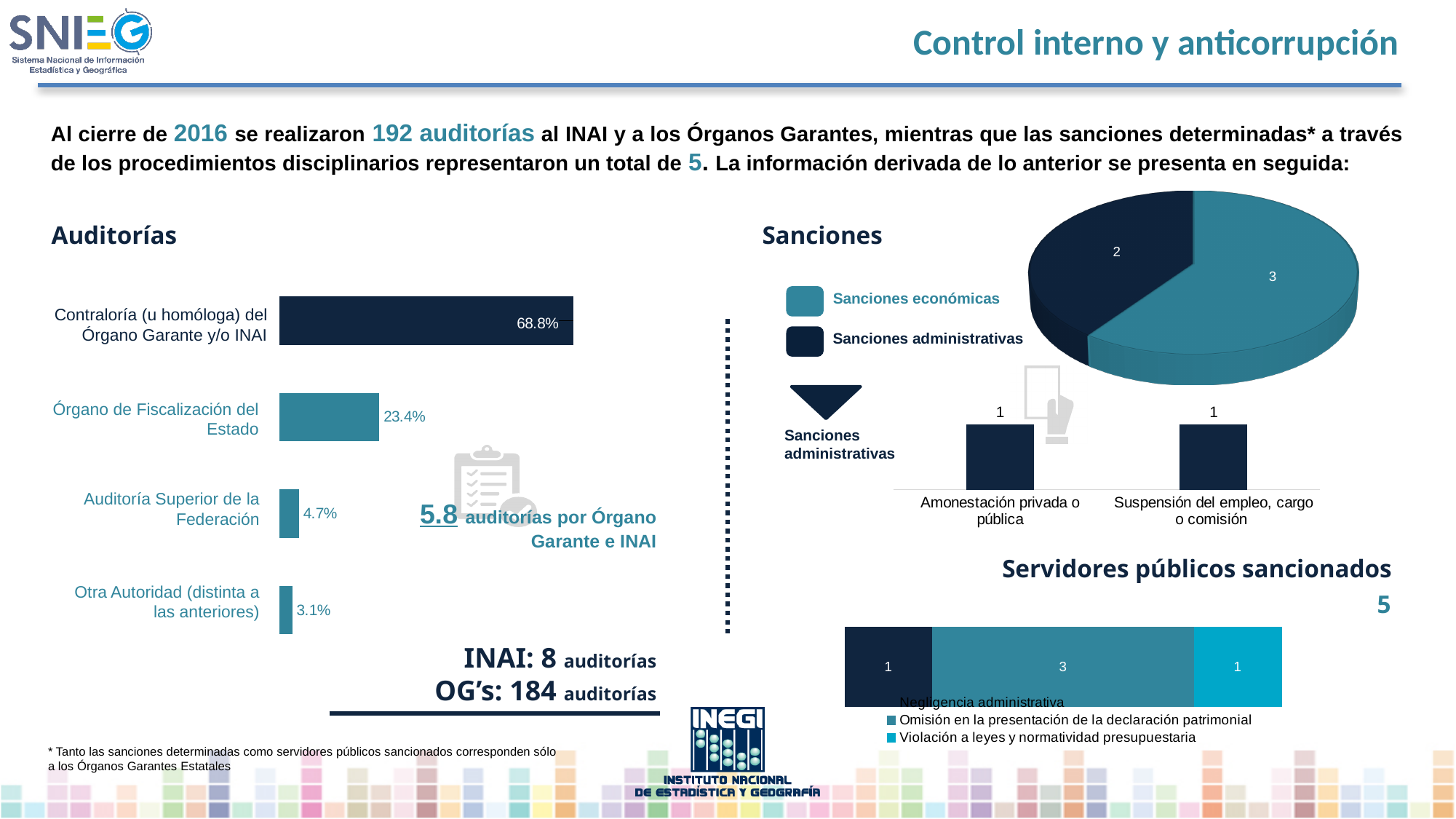
In the Auditorías bar chart, which category has the lowest value? Otra Autoridad (distinta a las anteriores) In the Auditorías bar chart, what is the value for Órgano de Fiscalización del Estado? 23.4% In the Auditorías bar chart, what is the value for Contraloría (u homóloga) del Órgano Garante y/o INAI? 68.8% In the Sanciones pie chart, what share of the total do Sanciones administrativas represent? 40% In the Sanciones administrativas bar chart, what is the value for Suspensión del empleo, cargo o comisión? 1 In the Servidores públicos sancionados stacked bar, what is the total of all segments? 5 In the Auditorías bar chart, what is the difference between Órgano de Fiscalización del Estado and Auditoría Superior de la Federación? 18.7% In the Sanciones pie chart, what is the value for Sanciones económicas? 3 What kind of chart is the Auditorías chart? Bar chart In the Auditorías bar chart, how many categories are shown? 4 In the Servidores públicos sancionados stacked bar, what is the value for Omisión en la presentación de la declaración patrimonial? 3 In the Sanciones pie chart, which is larger, Sanciones económicas or Sanciones administrativas? Sanciones económicas